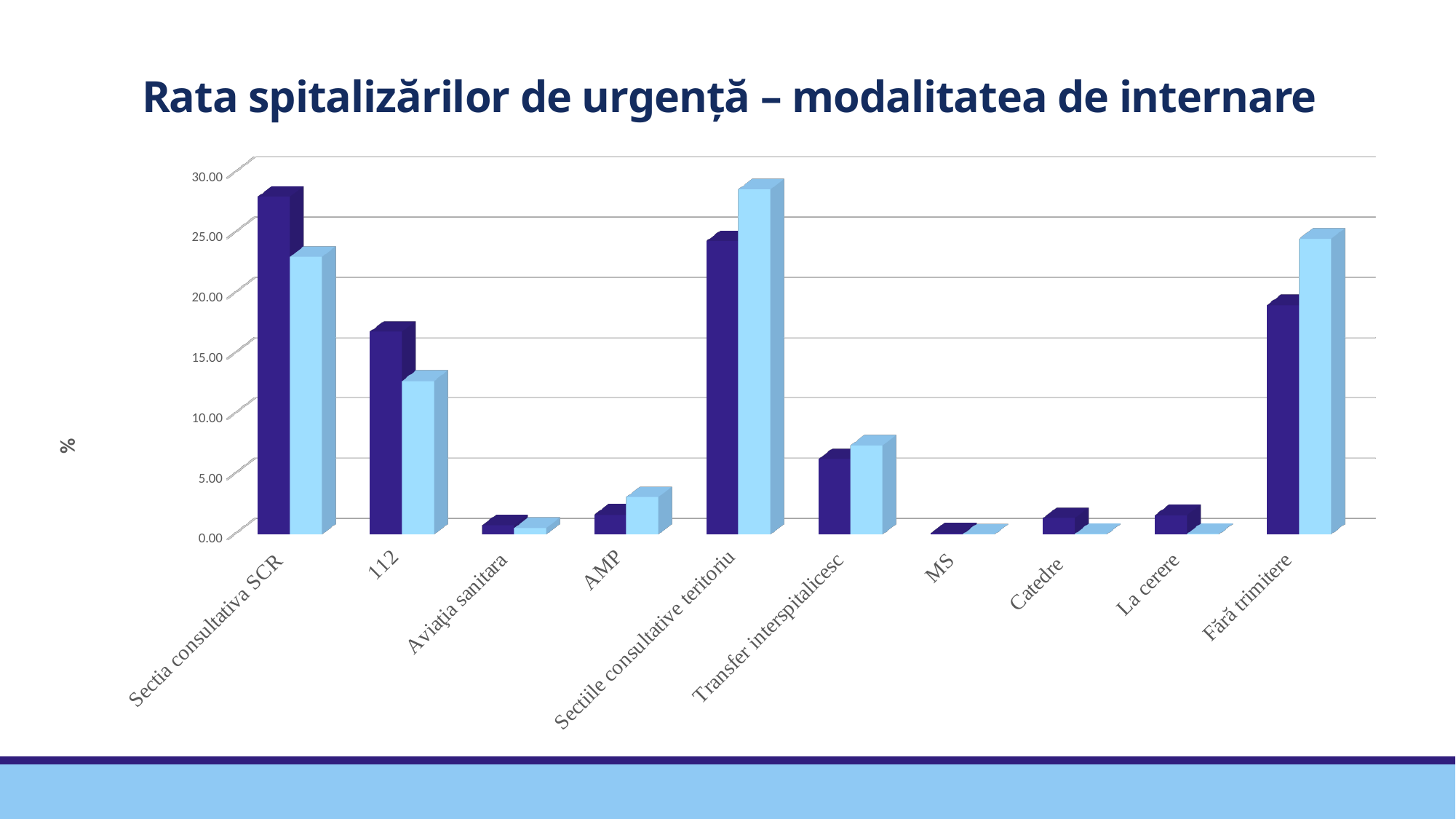
Is the dark blue value for Sectia consultativa SCR greater or less than 25.00? greater For 112, which bar is taller, the dark blue or the light blue one? dark blue Which category has the lowest dark blue bar? MS Is the light blue value for 112 greater or less than 15.00? less Is the light blue value for Fără trimitere greater or less than 20.00? greater What label is shown on the vertical axis of the chart? % What kind of chart is shown on the slide? Bar chart For Sectiile consultative teritoriu, which bar is taller, the dark blue or the light blue one? light blue Which category has the highest dark blue bar? Sectia consultativa SCR What is the title of the chart on the slide? Rata spitalizărilor de urgență – modalitatea de internare How many categories are shown along the x axis of the chart? 10 Which category has the highest light blue bar? Sectiile consultative teritoriu